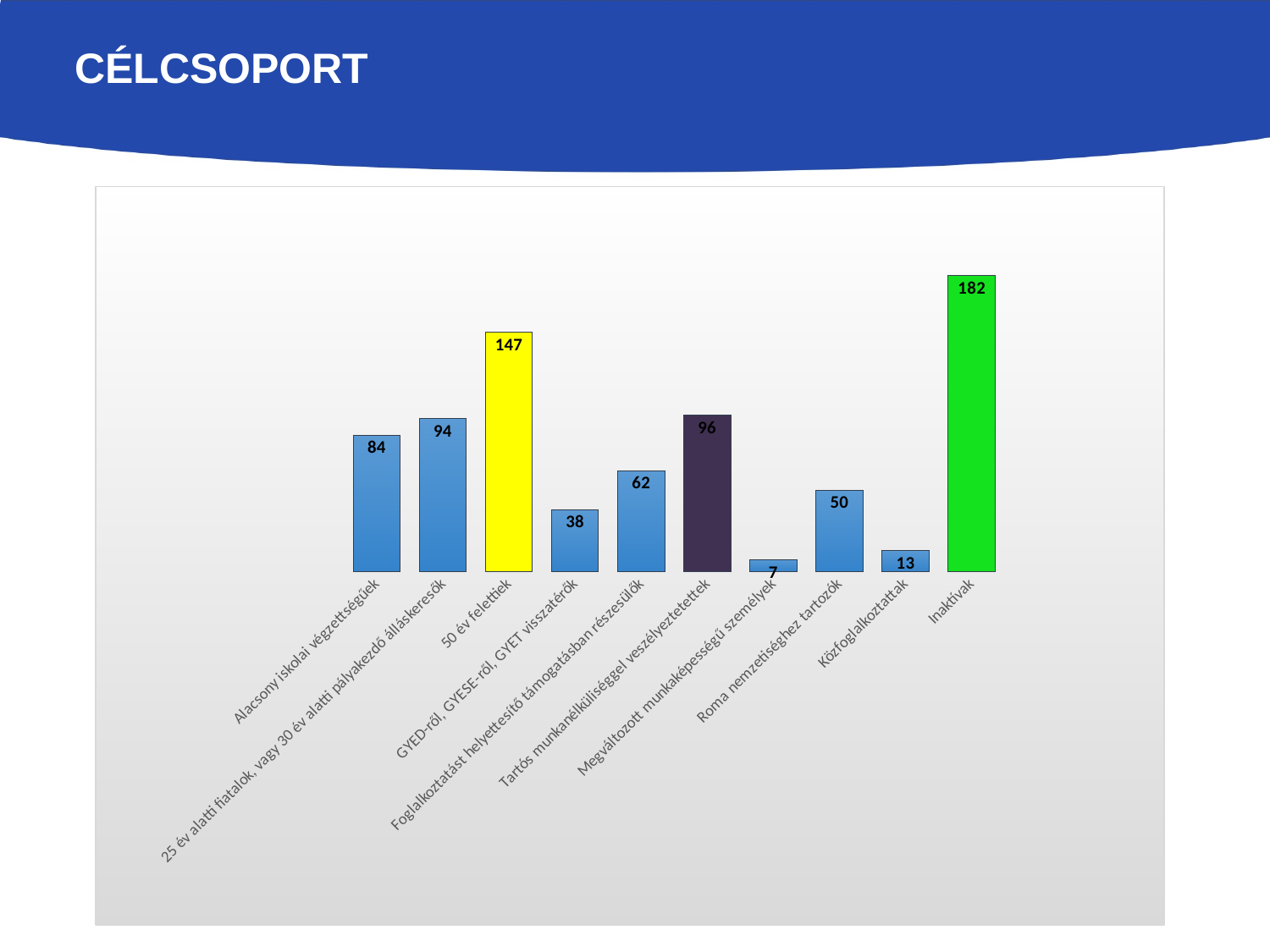
What is the difference between the values for Tartós munkanélküliséggel veszélyeztetettek and Roma nemzetiséghez tartozók? 46 What colour is the bar for Inaktívak? Green How many categories are shown in the chart? 10 What is the value for Tartós munkanélküliséggel veszélyeztetettek? 96 Which category has the lowest value? Megváltozott munkaképességű személyek What is the difference between the values for Inaktívak and 50 év felettiek? 35 Which is larger, the value for Alacsony iskolai végzettségűek or the value for Foglalkoztatást helyettesítő támogatásban részesülők? Alacsony iskolai végzettségűek What is the value for Inaktívak? 182 Which category has the highest value? Inaktívak What is the value for Közfoglalkoztattak? 13 What kind of chart is shown on the slide? Bar chart What is the value for 50 év felettiek? 147